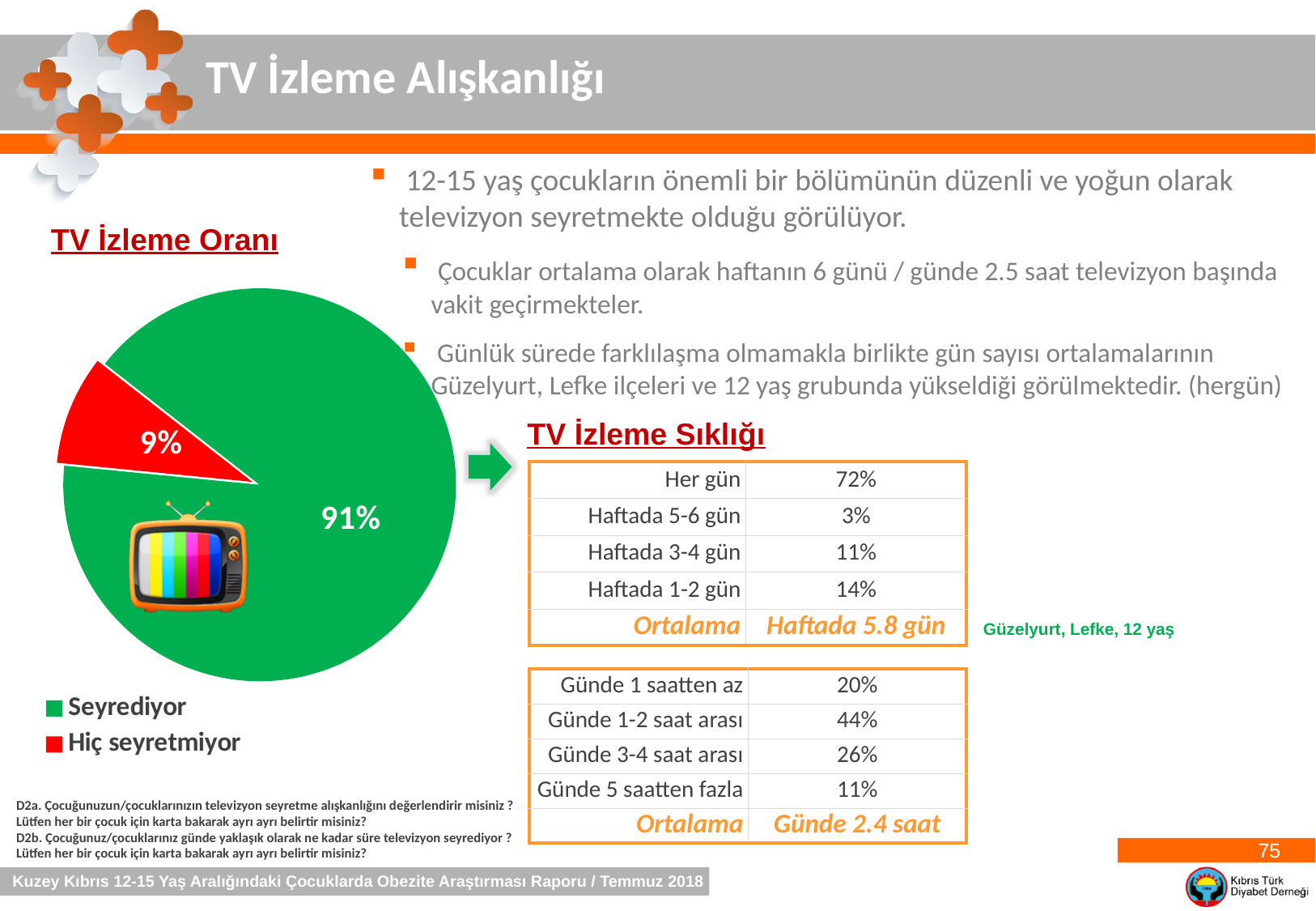
What kind of chart is shown under the title 'TV İzleme Oranı'? pie chart In the 'TV İzleme Oranı' pie chart, what percentage is shown for 'Hiç seyretmiyor'? 9% Which slice of the 'TV İzleme Oranı' pie chart is the largest? Seyrediyor In the 'TV İzleme Oranı' pie chart, which is larger: 'Seyrediyor' or 'Hiç seyretmiyor'? Seyrediyor In the 'TV İzleme Oranı' pie chart, what is the difference in percentage points between 'Seyrediyor' and 'Hiç seyretmiyor'? 82 In the 'TV İzleme Oranı' pie chart, what percentage is shown for 'Seyrediyor'? 91% How many entries does the legend of the 'TV İzleme Oranı' pie chart list? 2 What colour is the 'Hiç seyretmiyor' slice in the 'TV İzleme Oranı' pie chart? red Which slice of the 'TV İzleme Oranı' pie chart is the smallest? Hiç seyretmiyor What share of the 'TV İzleme Oranı' pie does the 'Hiç seyretmiyor' slice represent? 9% How many slices does the 'TV İzleme Oranı' pie chart have? 2 What colour is the 'Seyrediyor' slice in the 'TV İzleme Oranı' pie chart? green